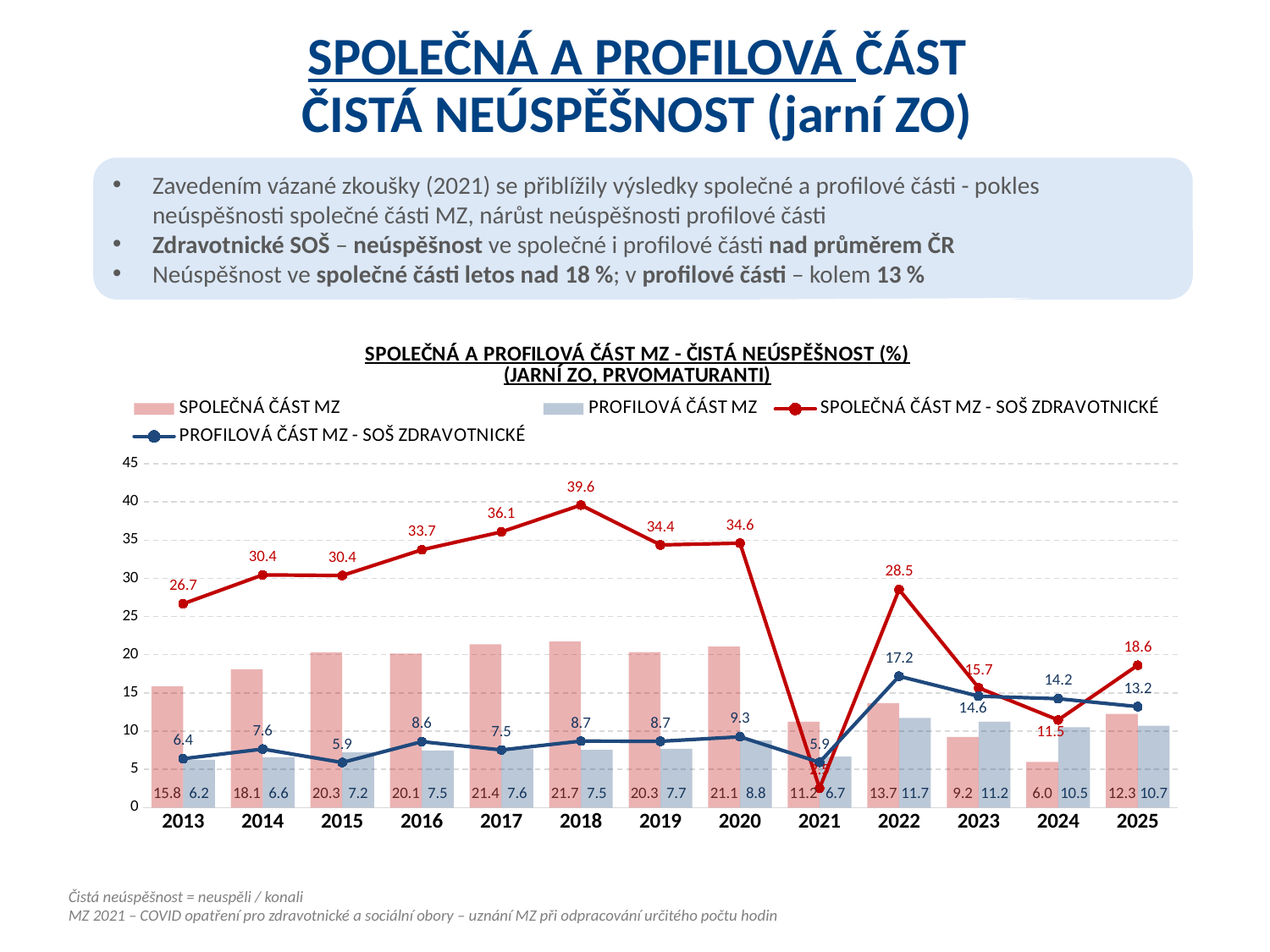
What is the value of the SPOLEČNÁ ČÁST MZ bar in 2025? 12.3 Is the value of SPOLEČNÁ ČÁST MZ - SOŠ ZDRAVOTNICKÉ in 2021 greater or less than 5? less What is the difference between SPOLEČNÁ ČÁST MZ - SOŠ ZDRAVOTNICKÉ and PROFILOVÁ ČÁST MZ - SOŠ ZDRAVOTNICKÉ in 2025? 5.4 In 2023, which is larger: the SPOLEČNÁ ČÁST MZ bar or the PROFILOVÁ ČÁST MZ bar? PROFILOVÁ ČÁST MZ In which year does the SPOLEČNÁ ČÁST MZ - SOŠ ZDRAVOTNICKÉ line reach its highest value? 2018 What is the value of PROFILOVÁ ČÁST MZ - SOŠ ZDRAVOTNICKÉ in 2022? 17.2 Does the SPOLEČNÁ ČÁST MZ - SOŠ ZDRAVOTNICKÉ line rise or fall from 2013 to 2018? rise What is the value of SPOLEČNÁ ČÁST MZ - SOŠ ZDRAVOTNICKÉ in 2018? 39.6 How many years are shown on the x axis of the chart? 13 What kind of chart is shown on the slide? Combined bar and line chart In which year is the SPOLEČNÁ ČÁST MZ bar lowest? 2024 How many series does the chart legend list? 4